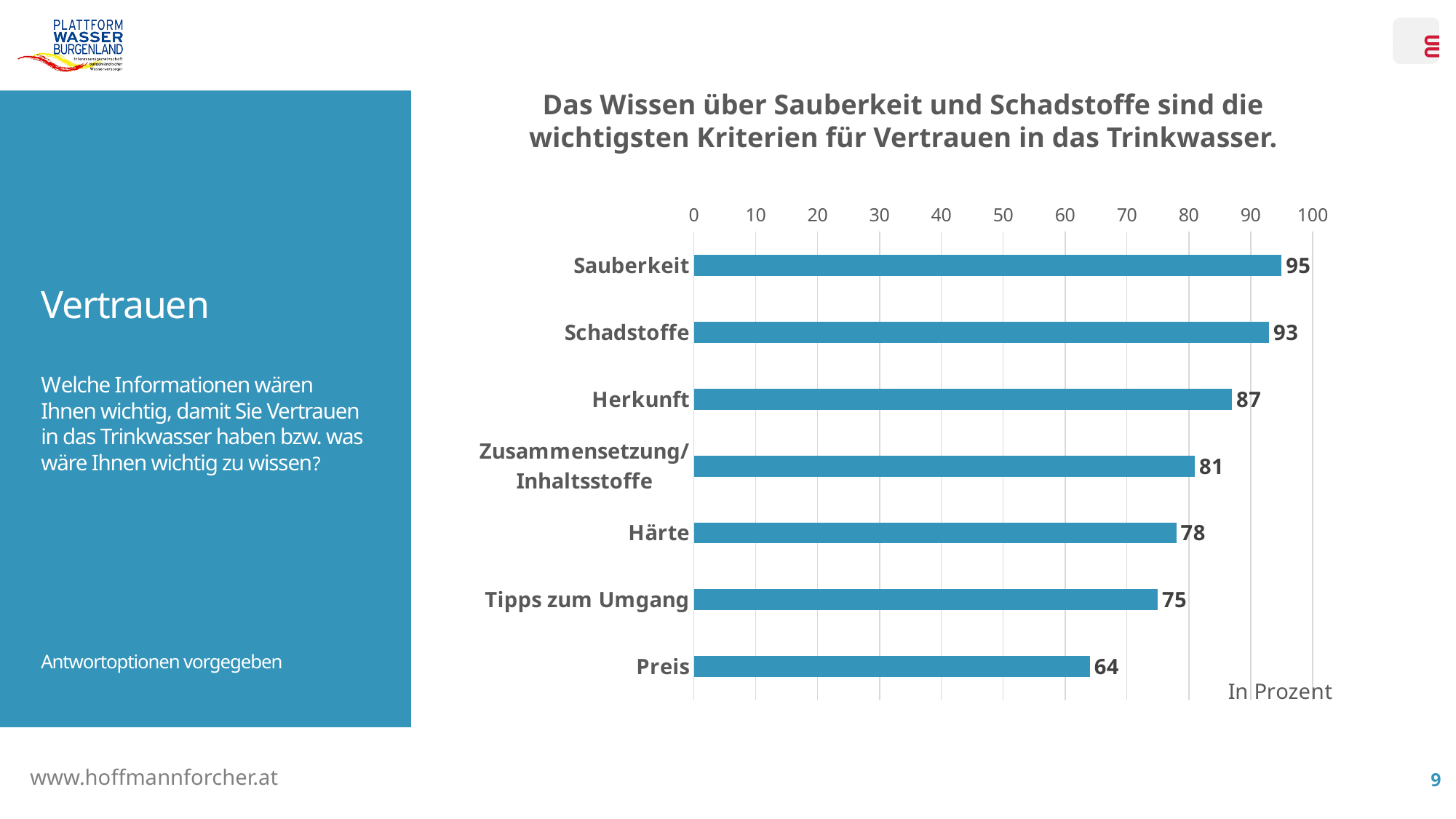
What is the value for Zusammensetzung/Inhaltsstoffe? 81 What is the value for Preis? 64 What is the value for Herkunft? 87 What is the difference between the values for Sauberkeit and Preis? 31 What unit is indicated in the bottom right corner of the chart? In Prozent Which category has the lowest value? Preis What is the value for Sauberkeit? 95 Which is larger, the value for Schadstoffe or the value for Herkunft? Schadstoffe What is the difference between the values for Härte and Tipps zum Umgang? 3 What kind of chart is shown on the slide? bar chart Which category has the highest value? Sauberkeit How many categories are shown in the chart? 7